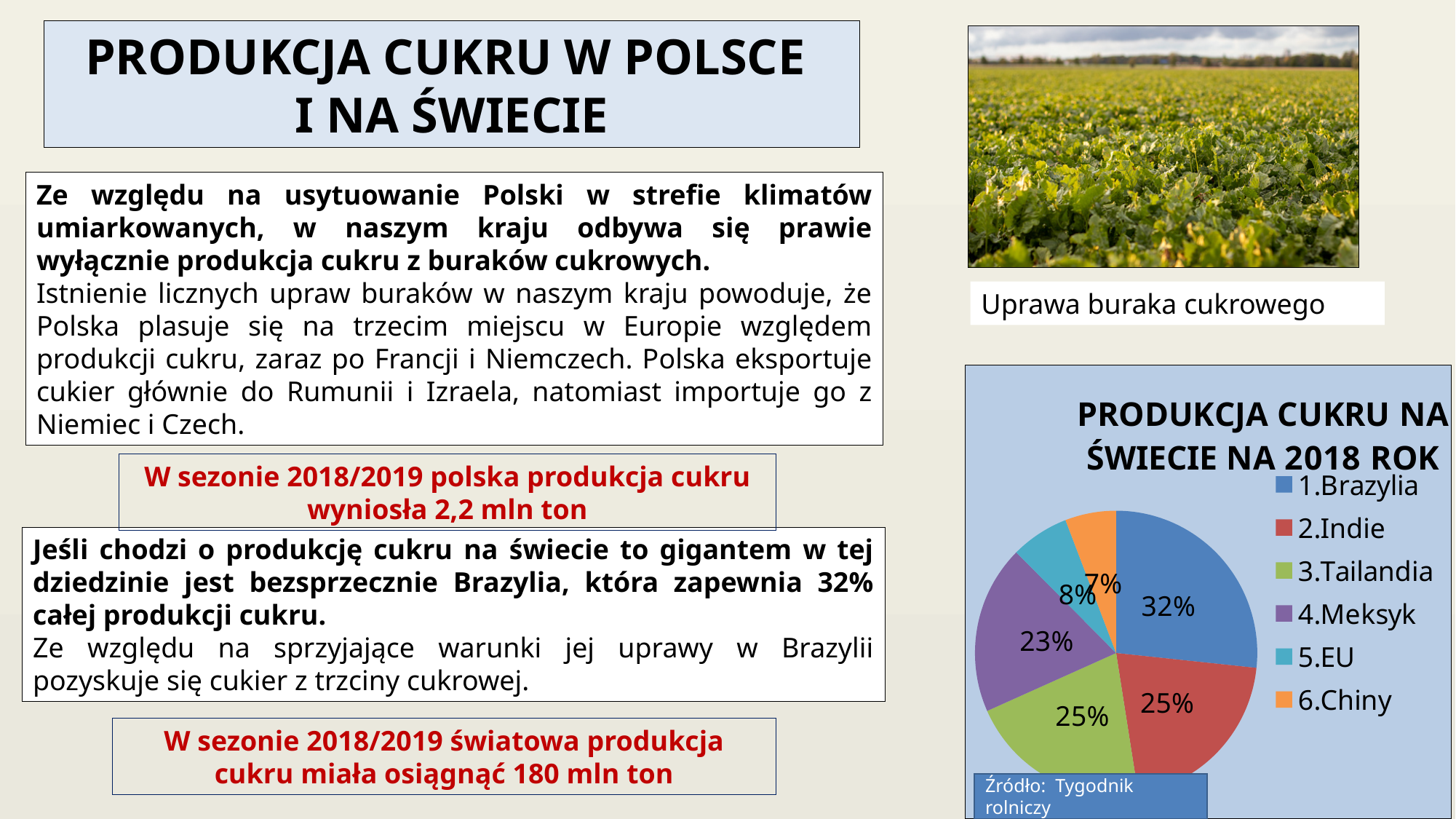
What share of the pie does 1.Brazylia have? 32% Which category has the smallest share of the pie? 6.Chiny What share of the pie does 4.Meksyk have? 23% Which has a larger share of the pie, 3.Tailandia or 5.EU? 3.Tailandia Which category has the largest share of the pie? 1.Brazylia How many categories does the pie chart legend list? 6 What kind of chart is shown on the slide? pie chart What is the title of the pie chart? PRODUKCJA CUKRU NA ŚWIECIE NA 2018 ROK What share of the pie does 2.Indie have? 25% What is the difference in percentage points between the shares of 1.Brazylia and 4.Meksyk? 9